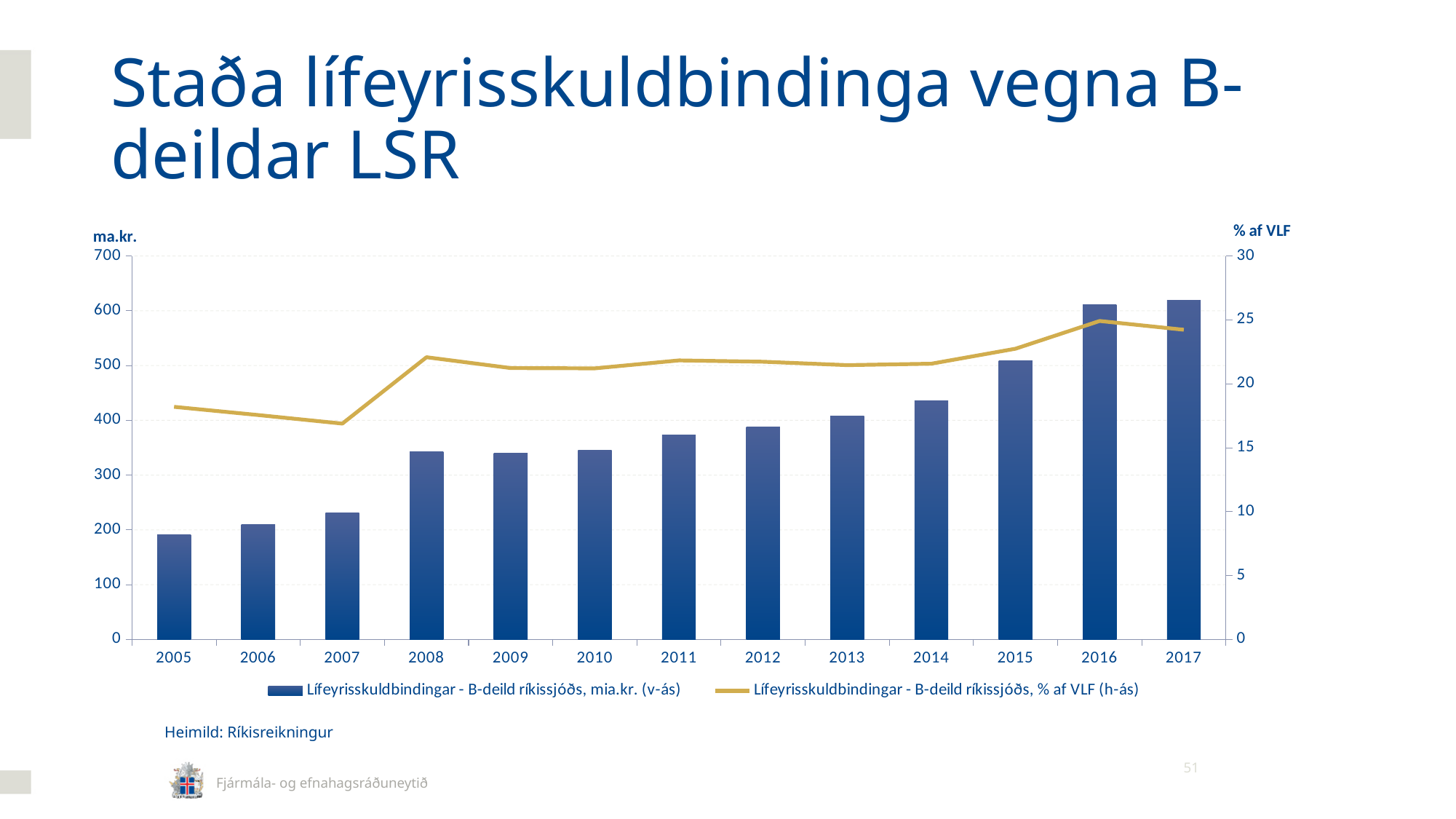
Do the bars for pension liabilities in ma.kr. generally rise or fall from 2005 to 2017? rise Is the bar value for 2011 greater or less than 400 ma.kr.? less Is the bar value for 2005 greater or less than 200 ma.kr.? less What kind of chart is used for the series 'Lífeyrisskuldbindingar - B-deild ríkissjóðs, mia.kr. (v-ás)'? bar chart Which year has the lowest bar for pension liabilities in ma.kr.? 2005 In which year does the line for pension liabilities as % af VLF reach its highest point? 2016 How many series does the chart legend list? 2 How many years are shown on the x axis of the chart? 13 Is the % af VLF value for 2007 greater or less than 20? less Which year has the larger bar, 2014 or 2015? 2015 In which year is the line for pension liabilities as % af VLF at its lowest? 2007